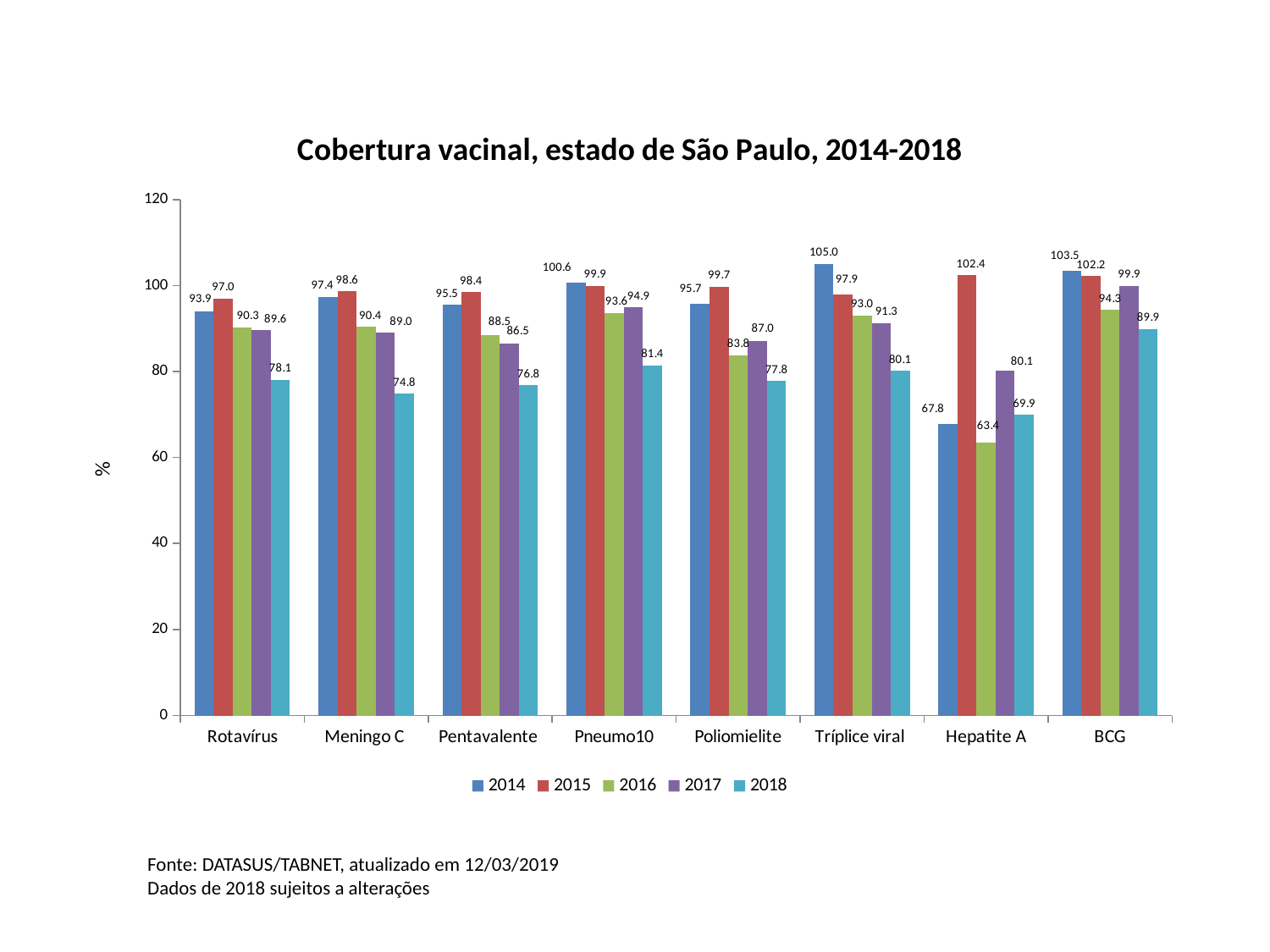
Is the 2014 value for Hepatite A greater or less than 80? less What type of chart is shown on the slide? bar chart How many series does the legend list? 5 Which vaccine has the highest 2014 value? Tríplice viral What is the difference between the 2014 and 2018 values for Meningo C? 22.6 What is the 2017 value for BCG? 99.9 Which is larger for Pneumo10: the 2016 value or the 2017 value? 2017 What is the 2015 value for Hepatite A? 102.4 What is the 2018 value for Rotavírus? 78.1 What is the title of the chart? Cobertura vacinal, estado de São Paulo, 2014-2018 Which vaccine has the lowest 2016 value? Hepatite A How many vaccine categories are shown on the x axis? 8